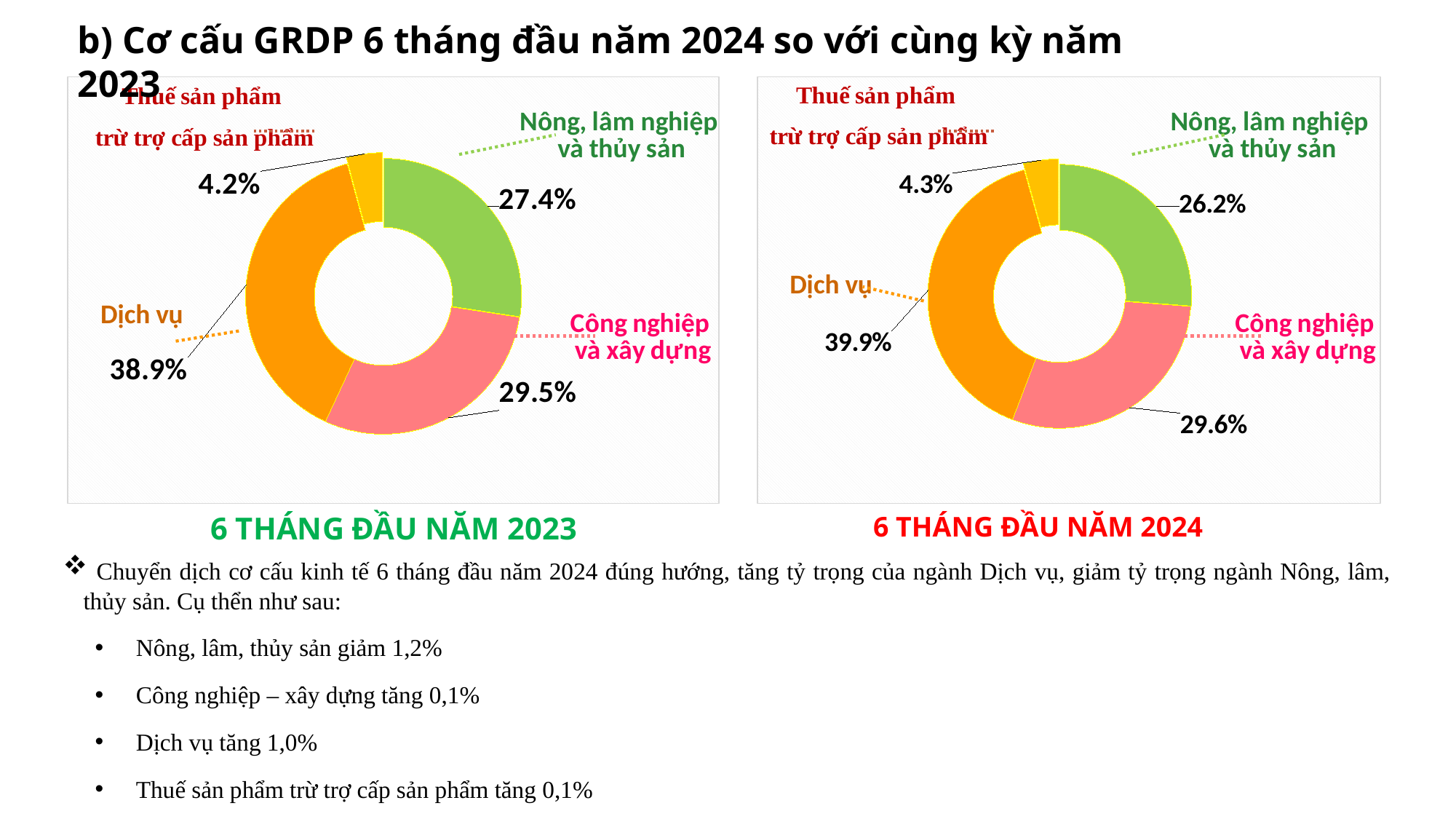
In the right chart (6 THÁNG ĐẦU NĂM 2024), what is the share for Thuế sản phẩm trừ trợ cấp sản phẩm? 4.3% In the right chart (6 THÁNG ĐẦU NĂM 2024), what is the share for Nông, lâm nghiệp và thủy sản? 26.2% What kind of chart is the right chart (6 THÁNG ĐẦU NĂM 2024)? Pie (doughnut) chart What is the difference between the Dịch vụ share in the right chart (2024) and in the left chart (2023)? 1.0% In the right chart (6 THÁNG ĐẦU NĂM 2024), which category has the smallest share? Thuế sản phẩm trừ trợ cấp sản phẩm What colour is the Dịch vụ slice in the left chart (6 THÁNG ĐẦU NĂM 2023)? Orange In the left chart (6 THÁNG ĐẦU NĂM 2023), what is the share for Dịch vụ? 38.9% In the left chart (6 THÁNG ĐẦU NĂM 2023), which is larger: Nông, lâm nghiệp và thủy sản or Công nghiệp và xây dựng? Công nghiệp và xây dựng In the left chart (6 THÁNG ĐẦU NĂM 2023), what is the share for Công nghiệp và xây dựng? 29.5% In the right chart (6 THÁNG ĐẦU NĂM 2024), what is the difference between the shares of Dịch vụ and Công nghiệp và xây dựng? 10.3% In the left chart (6 THÁNG ĐẦU NĂM 2023), which category has the largest share? Dịch vụ How many categories does the left chart (6 THÁNG ĐẦU NĂM 2023) show? 4